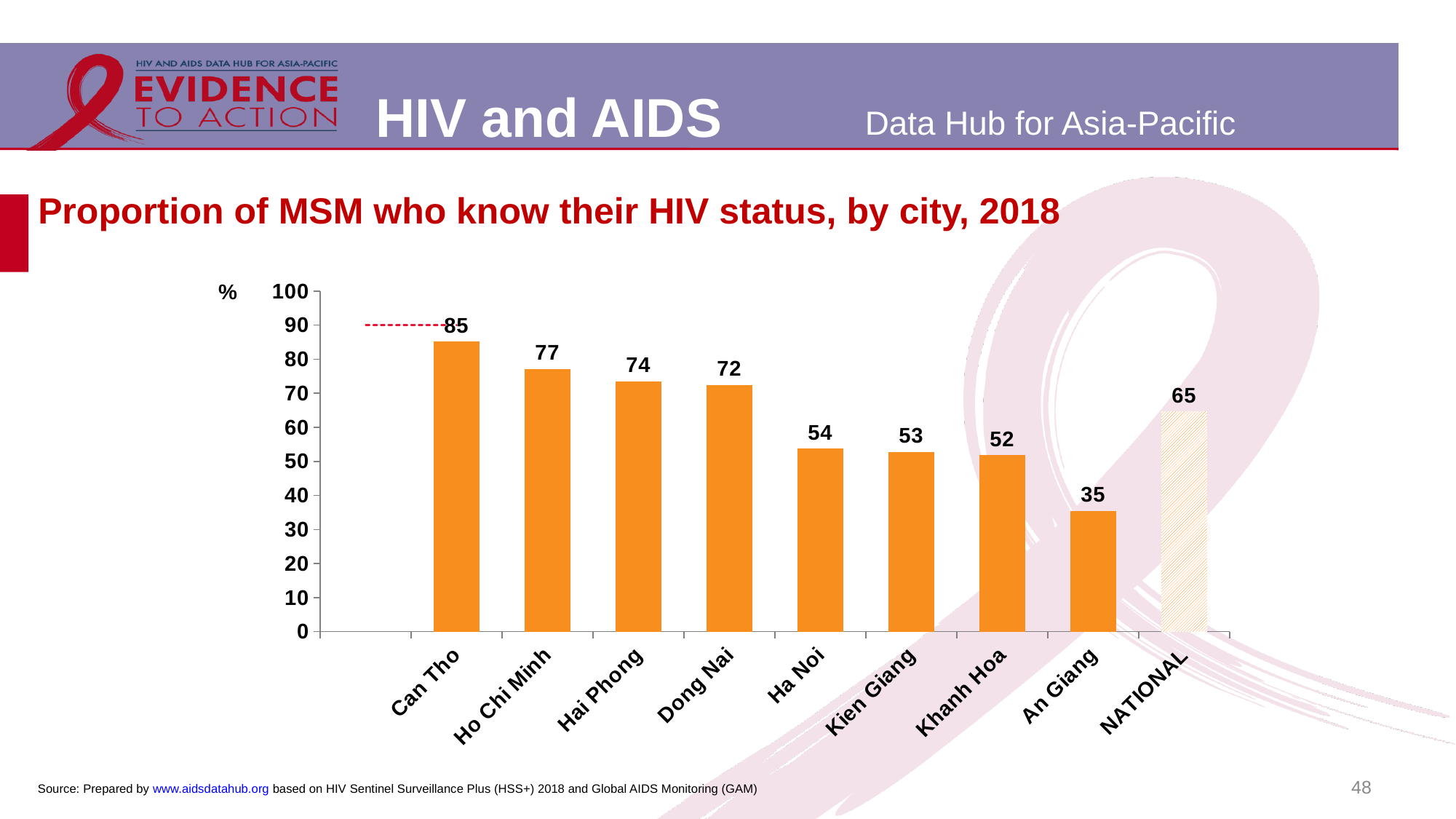
What kind of chart is shown on the slide? bar chart What is the NATIONAL value? 65 What is the value for Khanh Hoa? 52 Is the value for Dong Nai greater or less than 60? greater What is the title of the chart? Proportion of MSM who know their HIV status, by city, 2018 Which is larger, the value for Hai Phong or the value for Ha Noi? Hai Phong How many categories are shown on the x axis? 9 What is the difference between the values for Can Tho and An Giang? 50 Which city has the lowest proportion of MSM who know their HIV status? An Giang What is the value for Ho Chi Minh? 77 Which city has the highest proportion of MSM who know their HIV status? Can Tho What is the value for Can Tho? 85